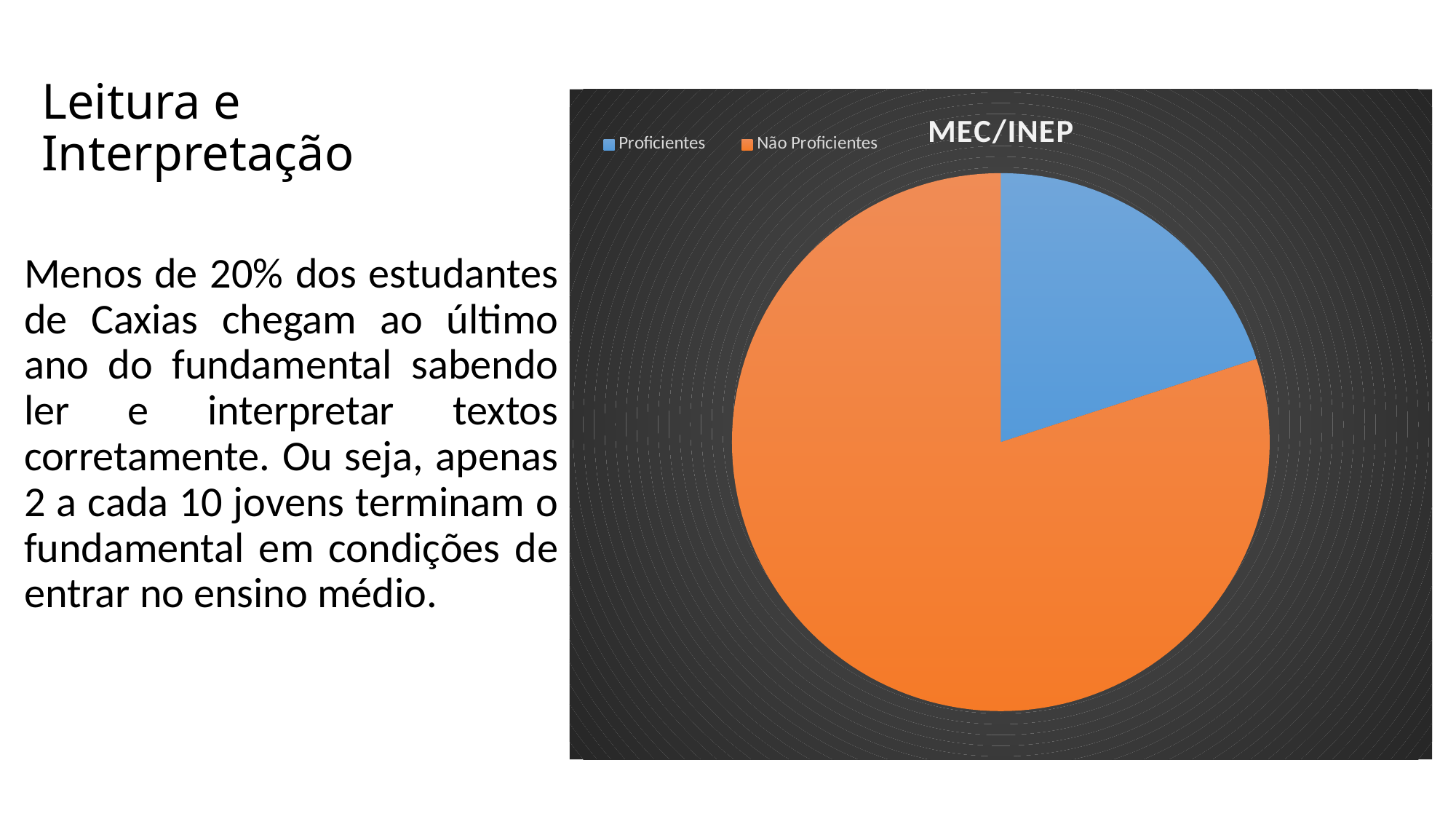
Which slice is larger, Proficientes or Não Proficientes? Não Proficientes Which slice of the pie chart is the smallest? Proficientes What colour is the Proficientes slice in the pie chart? blue How many entries does the chart legend list? 2 What kind of chart is shown on the slide? pie chart Which slice of the pie chart is the largest? Não Proficientes What is the title of the chart? MEC/INEP How many slices does the pie chart have? 2